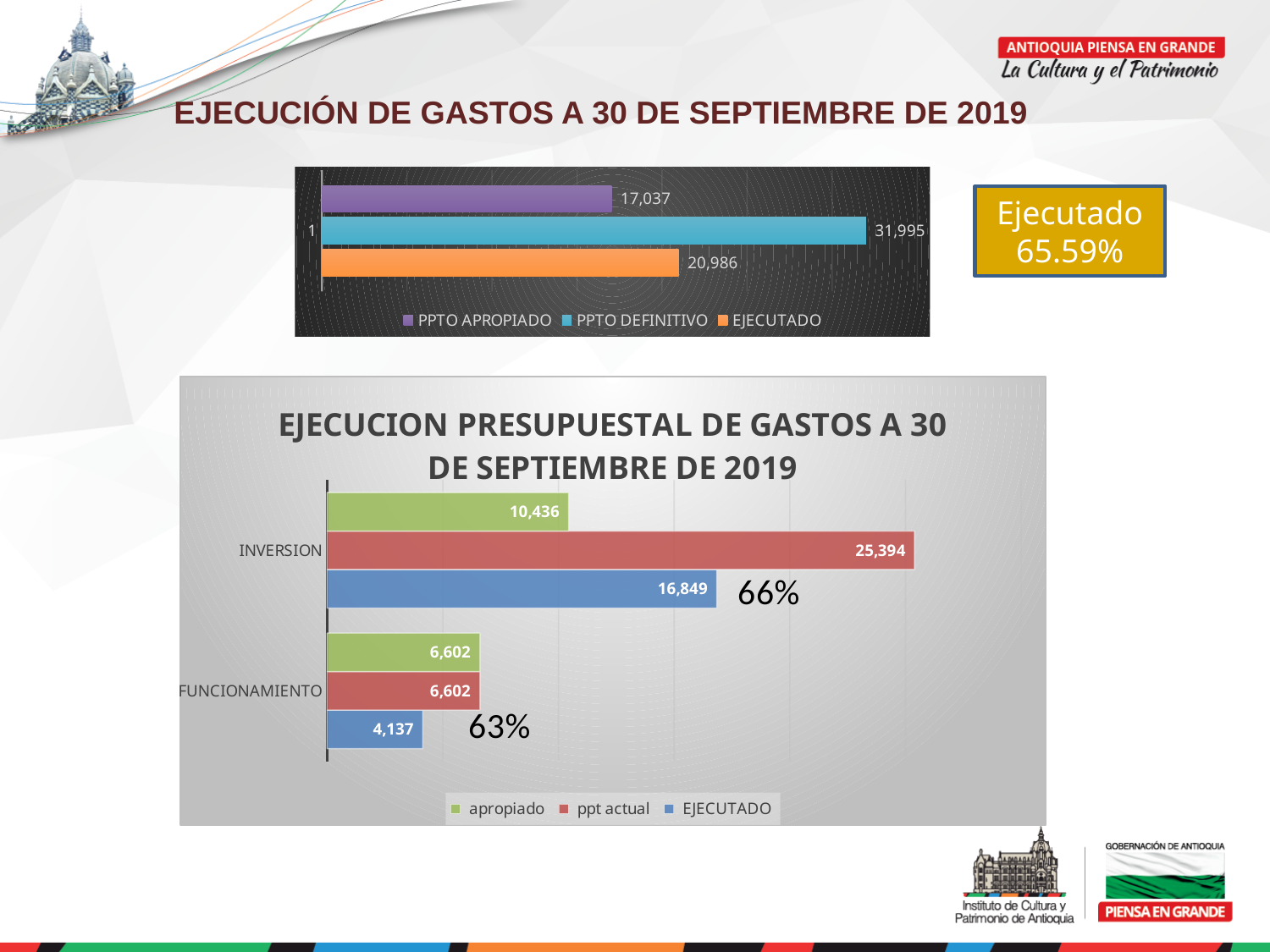
How many categories are shown in the chart titled 'EJECUCION PRESUPUESTAL DE GASTOS A 30 DE SEPTIEMBRE DE 2019'? 2 In the top chart on the slide, which series has the lowest value? PPTO APROPIADO In the top chart on the slide, what is the value for PPTO DEFINITIVO? 31,995 How many series does the legend of the top chart list? 3 In the top chart on the slide, what is the value for EJECUTADO? 20,986 What kind of chart is the chart titled 'EJECUCION PRESUPUESTAL DE GASTOS A 30 DE SEPTIEMBRE DE 2019'? Bar chart In the chart titled 'EJECUCION PRESUPUESTAL DE GASTOS A 30 DE SEPTIEMBRE DE 2019', what is the ppt actual value for INVERSION? 25,394 In the chart titled 'EJECUCION PRESUPUESTAL DE GASTOS A 30 DE SEPTIEMBRE DE 2019', what is the EJECUTADO value for FUNCIONAMIENTO? 4,137 In the chart titled 'EJECUCION PRESUPUESTAL DE GASTOS A 30 DE SEPTIEMBRE DE 2019', what is the difference between the ppt actual and apropiado values for INVERSION? 14,958 In the top chart on the slide, what is the difference between PPTO DEFINITIVO and EJECUTADO? 11,009 In the chart titled 'EJECUCION PRESUPUESTAL DE GASTOS A 30 DE SEPTIEMBRE DE 2019', which colour represents the EJECUTADO series? Blue In the chart titled 'EJECUCION PRESUPUESTAL DE GASTOS A 30 DE SEPTIEMBRE DE 2019', which is larger: the EJECUTADO value for INVERSION or the EJECUTADO value for FUNCIONAMIENTO? INVERSION